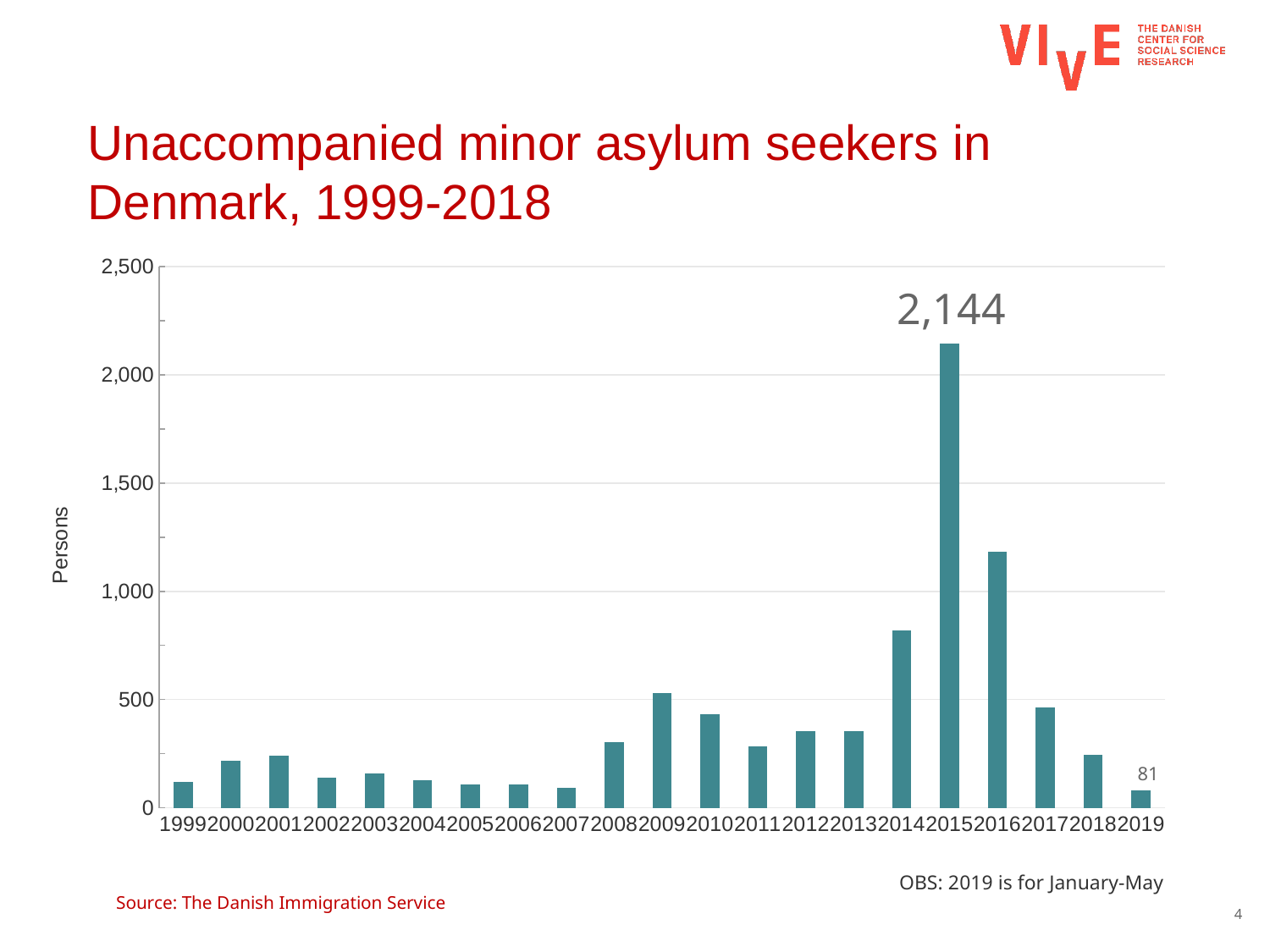
Is the value for 2017 greater or less than 500? less What kind of chart is shown on the slide? Bar chart Which year has the larger value, 2009 or 2010? 2009 How many years (bars) are shown on the chart? 21 Which year has the highest number of unaccompanied minor asylum seekers? 2015 What is the value for 2015? 2,144 What is the value for 2019? 81 Is the value for 2016 greater or less than 1,000? greater What is the difference between the values for 2015 and 2019? 2,063 Do the values rise or fall from 2015 to 2019? Fall Which year has the larger value, 2014 or 2016? 2016 Is the value for 2014 greater or less than 1,000? less